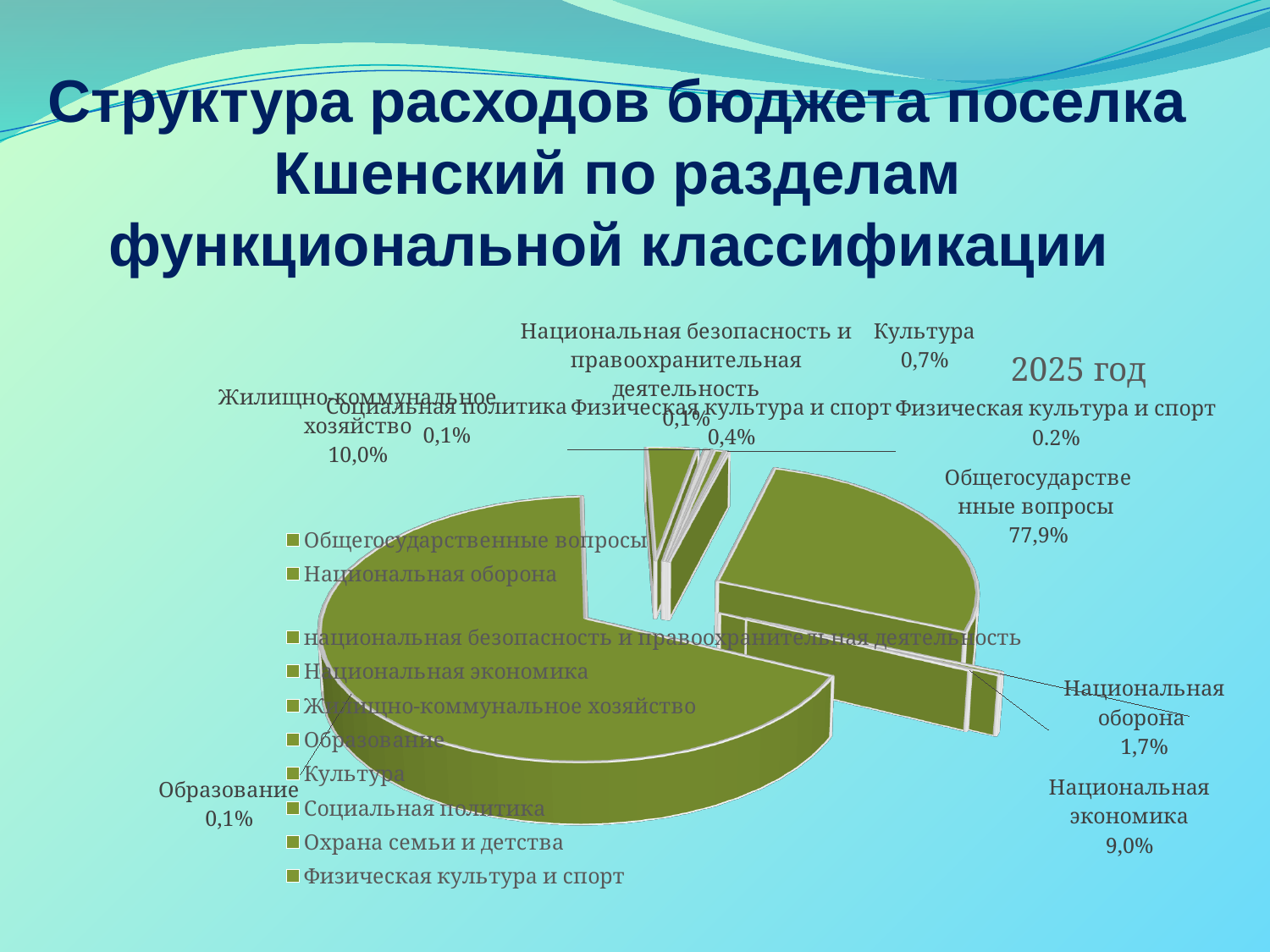
What share is labelled for Жилищно-коммунальное хозяйство? 10,0% What type of chart is shown on the slide? pie chart Which category has the largest share of the pie? Общегосударственные вопросы How many entries does the chart legend list? 10 Which is larger: the share for Жилищно-коммунальное хозяйство or for Национальная экономика? Жилищно-коммунальное хозяйство What share of expenditures is labelled for Общегосударственные вопросы? 77,9% What share is labelled for Культура? 0,7% What year is shown as the chart's title? 2025 год What is the difference between the shares for Общегосударственные вопросы and Жилищно-коммунальное хозяйство? 67,9% What share is labelled for Национальная экономика? 9,0% What share is labelled for Национальная оборона? 1,7% What share is labelled for Образование? 0,1%